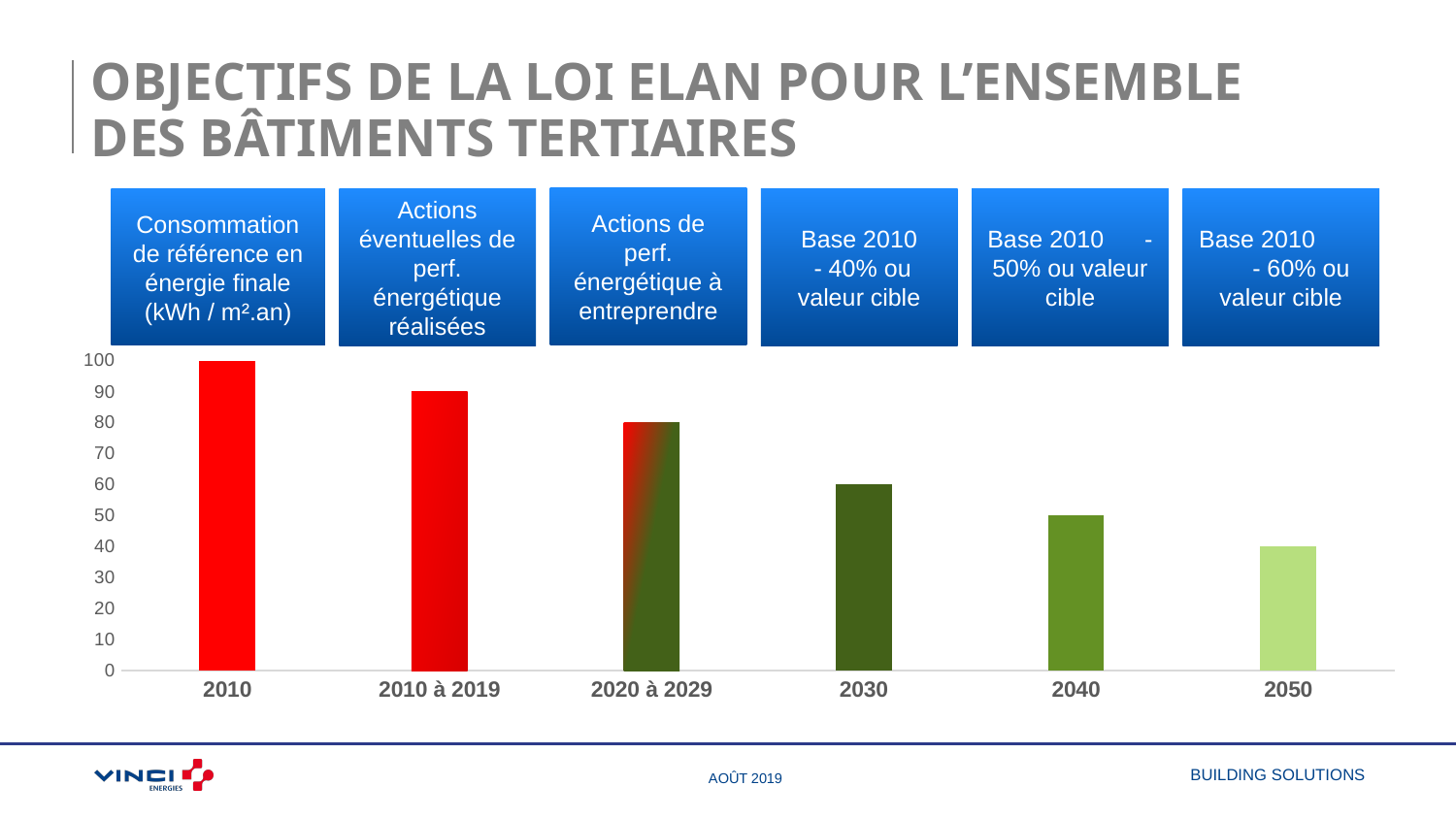
Which category has the lowest bar? 2050 What is the value of the bar for 2050? 40 Do the bar values rise or fall from left to right along the x axis? fall What is the highest value shown on the y axis of the chart? 100 What is the value of the bar for 2030? 60 How many categories are shown on the x axis of the chart? 6 What is the value of the bar for 2010? 100 What is the value of the bar for 2040? 50 What type of chart is shown on the slide? bar chart Which category has the highest bar? 2010 Which is larger, the value for 2010 à 2019 or the value for 2030? 2010 à 2019 What is the difference between the values for 2010 and 2050? 60